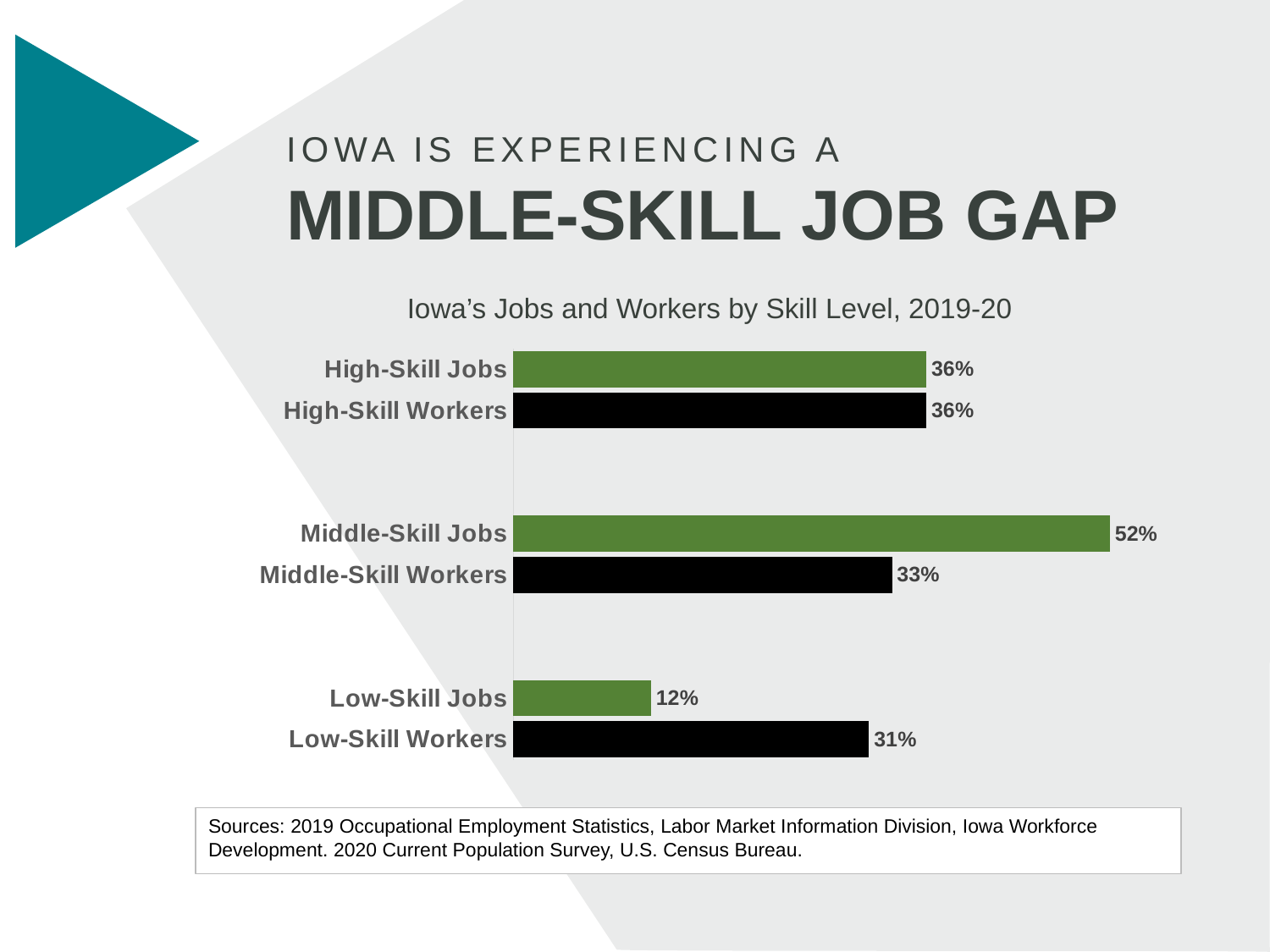
What is the title of the chart? Iowa's Jobs and Workers by Skill Level, 2019-20 What is the value for Middle-Skill Workers? 33% How many bars are shown in the chart? 6 What is the value for High-Skill Workers? 36% What is the value for Low-Skill Jobs? 12% What is the value for Middle-Skill Jobs? 52% What is the difference between Middle-Skill Jobs and Middle-Skill Workers? 19% Which is larger, Low-Skill Jobs or Low-Skill Workers? Low-Skill Workers Which category has the highest value? Middle-Skill Jobs What is the difference between Low-Skill Workers and Low-Skill Jobs? 19% What kind of chart is shown on the slide? Bar chart Which category has the lowest value? Low-Skill Jobs